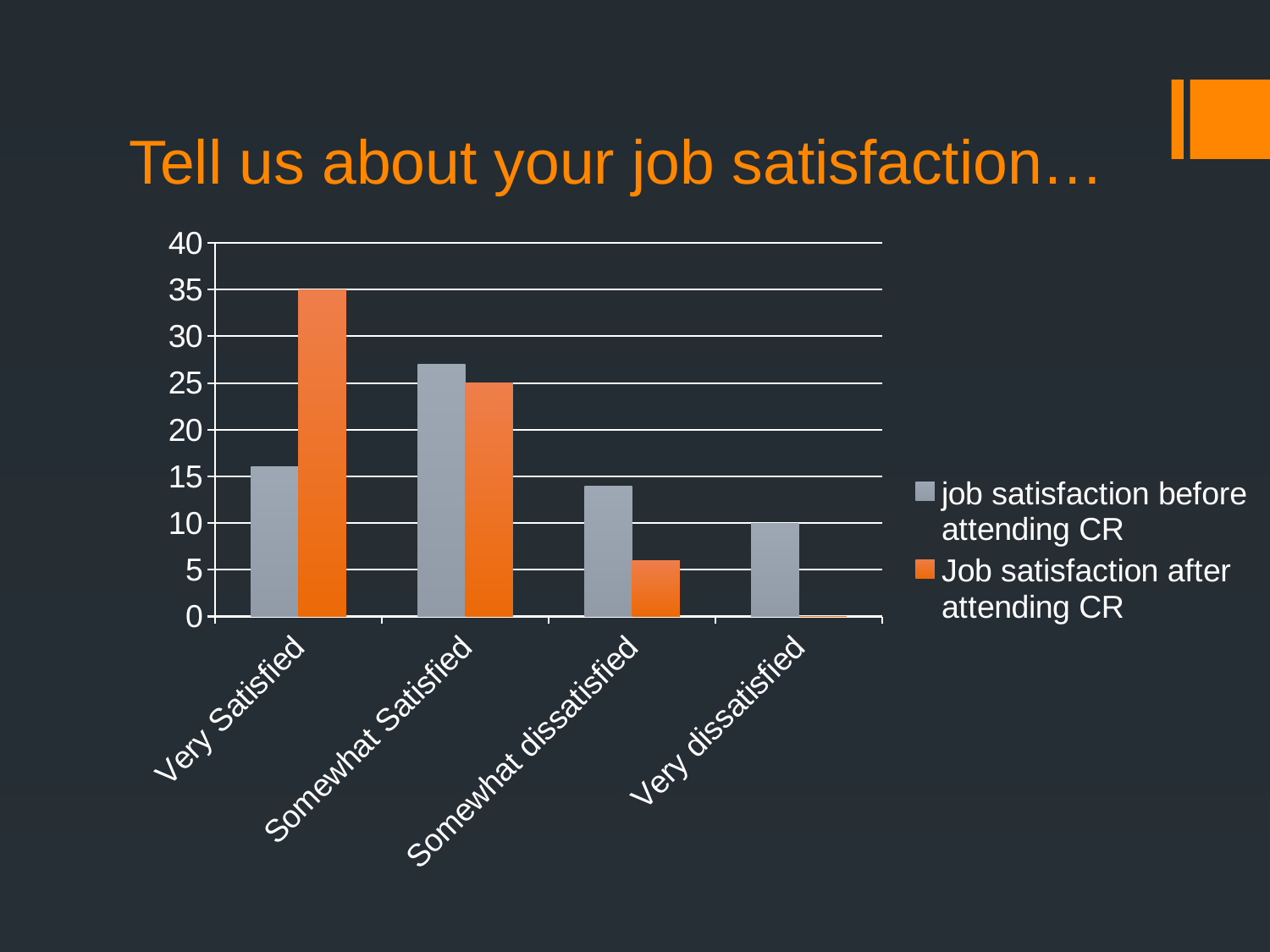
Which category has the highest value in the 'Job satisfaction after attending CR' series? Very Satisfied What is the value for Very Satisfied in the 'Job satisfaction after attending CR' series? 35 Is the value for Very Satisfied in the 'job satisfaction before attending CR' series greater or less than 20? less What is the difference between the 'Job satisfaction after attending CR' values for Very Satisfied and Somewhat Satisfied? 10 What is the value for Somewhat Satisfied in the 'Job satisfaction after attending CR' series? 25 What kind of chart is shown on the slide? bar chart What colour represents the 'Job satisfaction after attending CR' series? orange What is the value for Very dissatisfied in the 'job satisfaction before attending CR' series? 10 How many categories are shown on the x axis of the chart? 4 For Very Satisfied, which is larger: the value before attending CR or after attending CR? after attending CR Which category has the lowest value in the 'Job satisfaction after attending CR' series? Very dissatisfied How many series does the legend list? 2